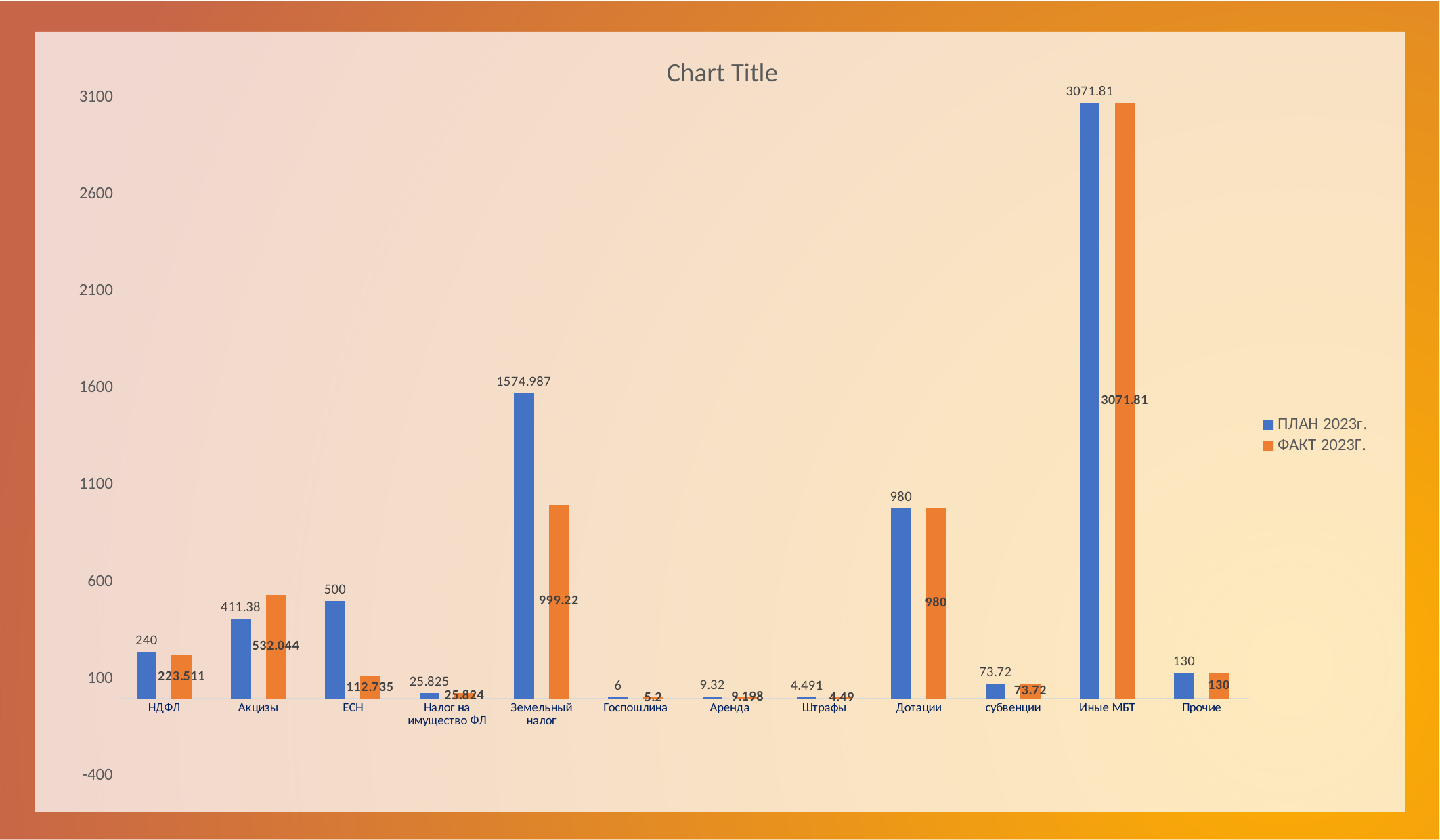
Which category has the lowest ПЛАН 2023г. value? Штрафы What is the ФАКТ 2023Г. value for Акцизы? 532.044 How many series does the legend list? 2 Which category has the highest ПЛАН 2023г. value? Иные МБТ What is the difference between the ПЛАН 2023г. and ФАКТ 2023Г. values for Земельный налог? 575.767 What is the difference between the ФАКТ 2023Г. and ПЛАН 2023г. values for Акцизы? 120.664 What is the ФАКТ 2023Г. value for ЕСН? 112.735 How many categories are shown on the x axis? 12 What is the ПЛАН 2023г. value for Земельный налог? 1574.987 For ЕСН, which is larger: the ПЛАН 2023г. value or the ФАКТ 2023Г. value? ПЛАН 2023г. What is the ПЛАН 2023г. value for НДФЛ? 240 What kind of chart is shown on the slide? Bar chart